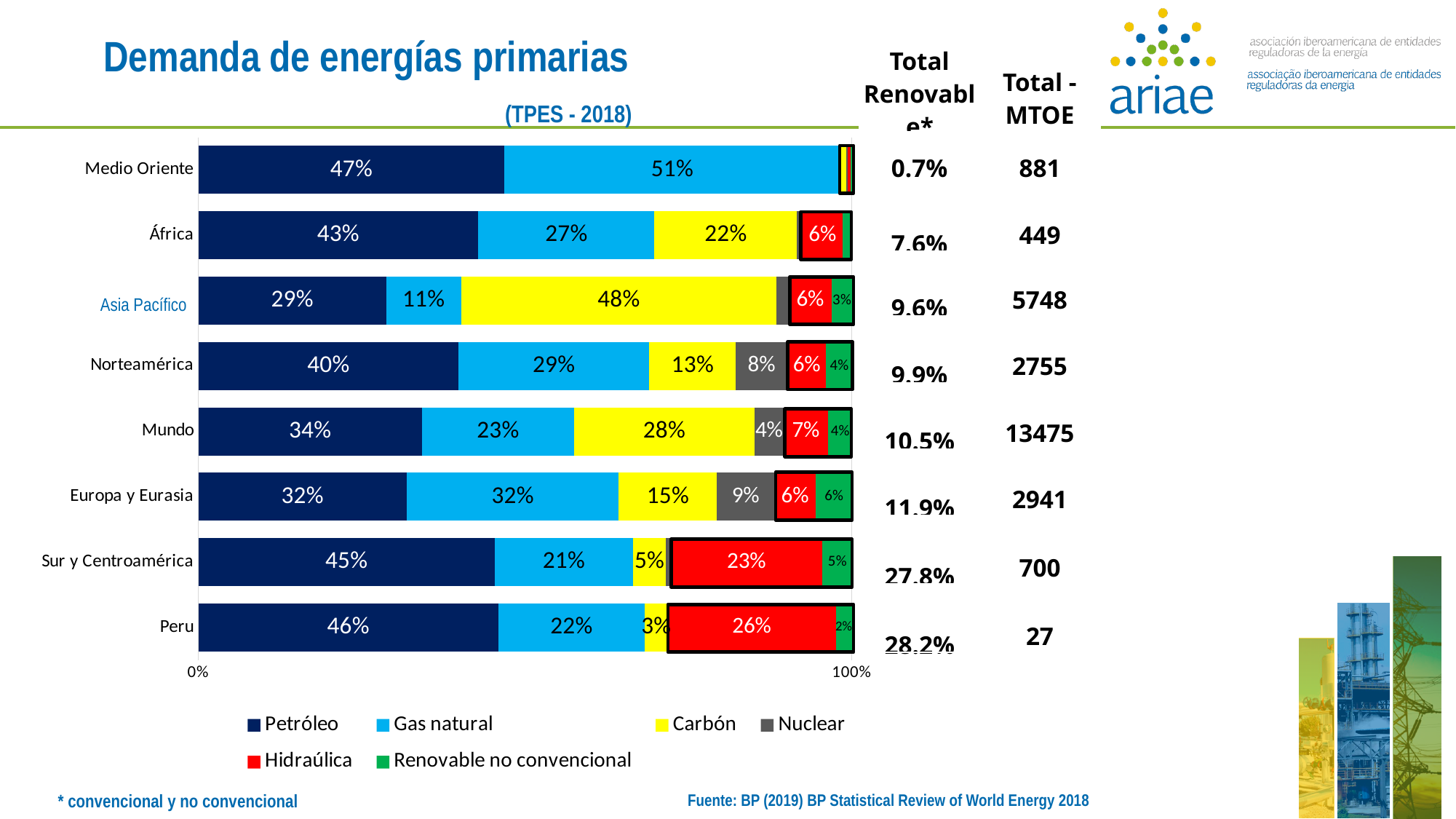
What is the Gas natural share for Medio Oriente? 51% What is the Hidraúlica share for Peru? 26% What kind of chart is shown on the slide? Stacked bar chart How many regions (categories) are plotted in the chart? 8 How many series does the legend list? 6 What is the difference in Carbón share between Mundo and Norteamérica? 15 percentage points Which has a larger Gas natural share, Medio Oriente or África? Medio Oriente What is the Petróleo share for Medio Oriente? 47% Which region has the highest Hidraúlica share? Peru Which region has the highest Carbón share? Asia Pacífico What is the Nuclear share for Europa y Eurasia? 9% What is the Carbón share for Asia Pacífico? 48%